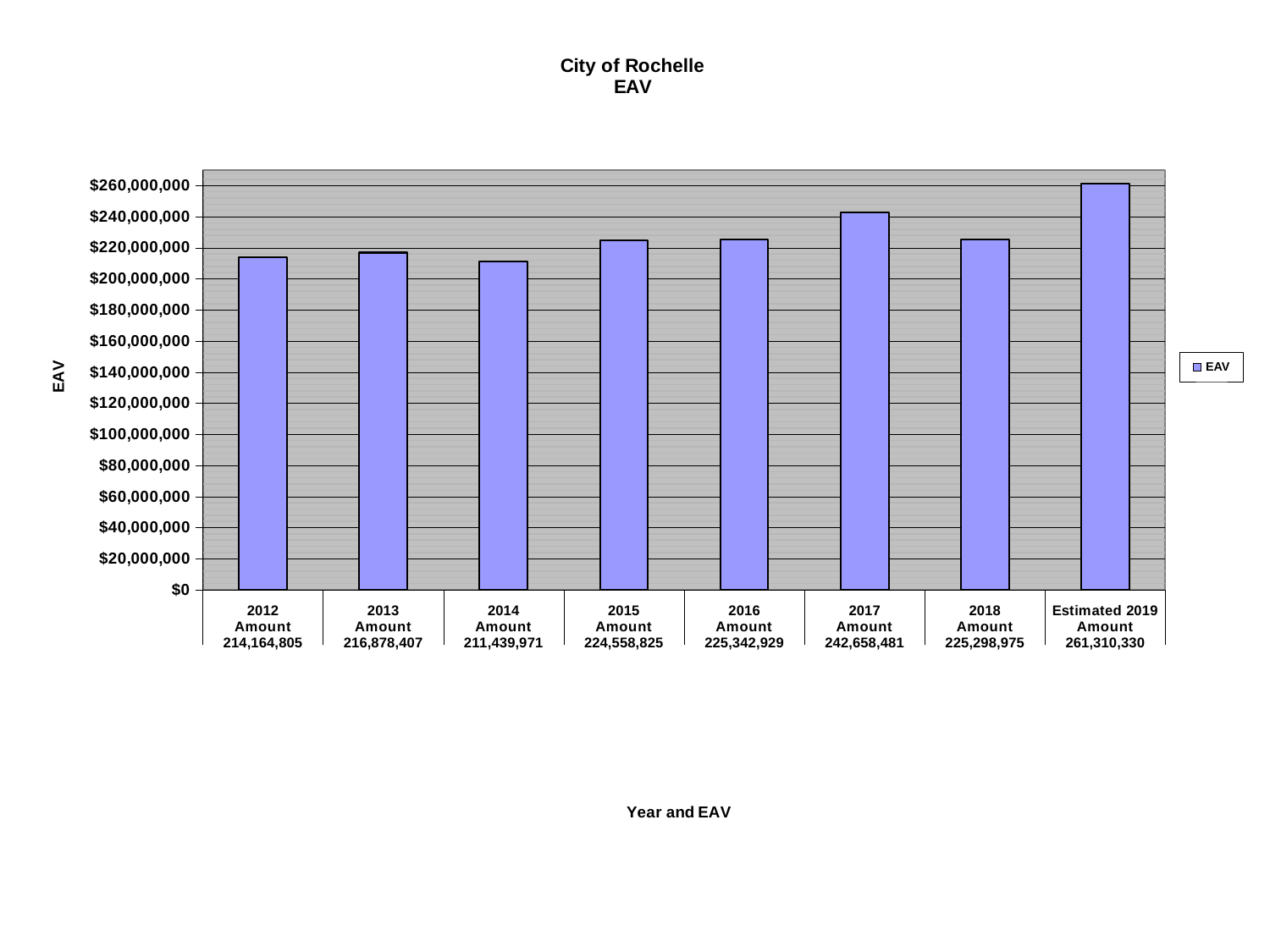
What is the title of the chart? City of Rochelle EAV What is the difference between the 2017 EAV amount and the 2016 EAV amount? 17,315,552 How many series does the legend list? 1 What is the EAV amount for 2017? 242,658,481 Is the EAV for 2014 greater or less than $220,000,000? less What is the EAV amount for 2012? 214,164,805 Which year has the lowest EAV? 2014 Which is larger, the EAV for 2013 or for 2014? 2013 What is the Estimated 2019 EAV amount? 261,310,330 Which year has the highest EAV? Estimated 2019 How many years (bars) are shown in the chart? 8 What type of chart is shown on the slide? Bar chart